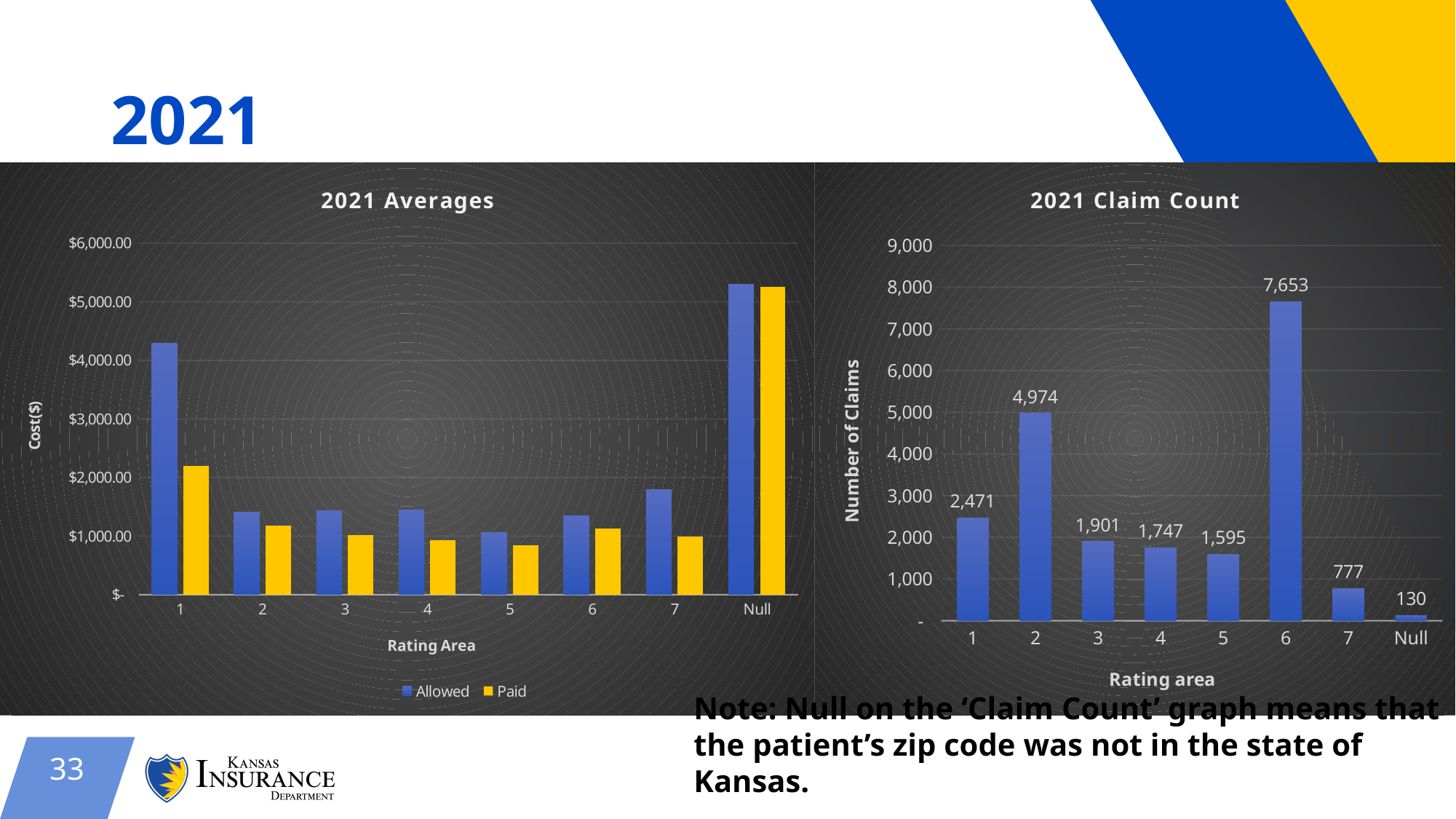
In the '2021 Claim Count' chart, which rating area has the highest number of claims? 6 In the '2021 Claim Count' chart, what is the number of claims for the Null rating area? 130 In the '2021 Averages' chart, is the Allowed value for rating area 1 greater or less than $4,000.00? greater In the '2021 Claim Count' chart, which has more claims, rating area 3 or rating area 5? Rating area 3 How many series does the legend of the '2021 Averages' chart list? 2 In the '2021 Claim Count' chart, which rating area has the lowest number of claims? Null What kind of chart is the '2021 Averages' chart? Bar chart In the '2021 Claim Count' chart, what is the difference in claims between rating area 6 and rating area 2? 2,679 In the '2021 Claim Count' chart, what is the number of claims for rating area 6? 7,653 In the '2021 Claim Count' chart, what is the number of claims for rating area 2? 4,974 In the '2021 Averages' chart, is the Paid value for rating area 5 greater or less than $1,000.00? less How many rating area categories are shown on the x axis of the '2021 Claim Count' chart? 8